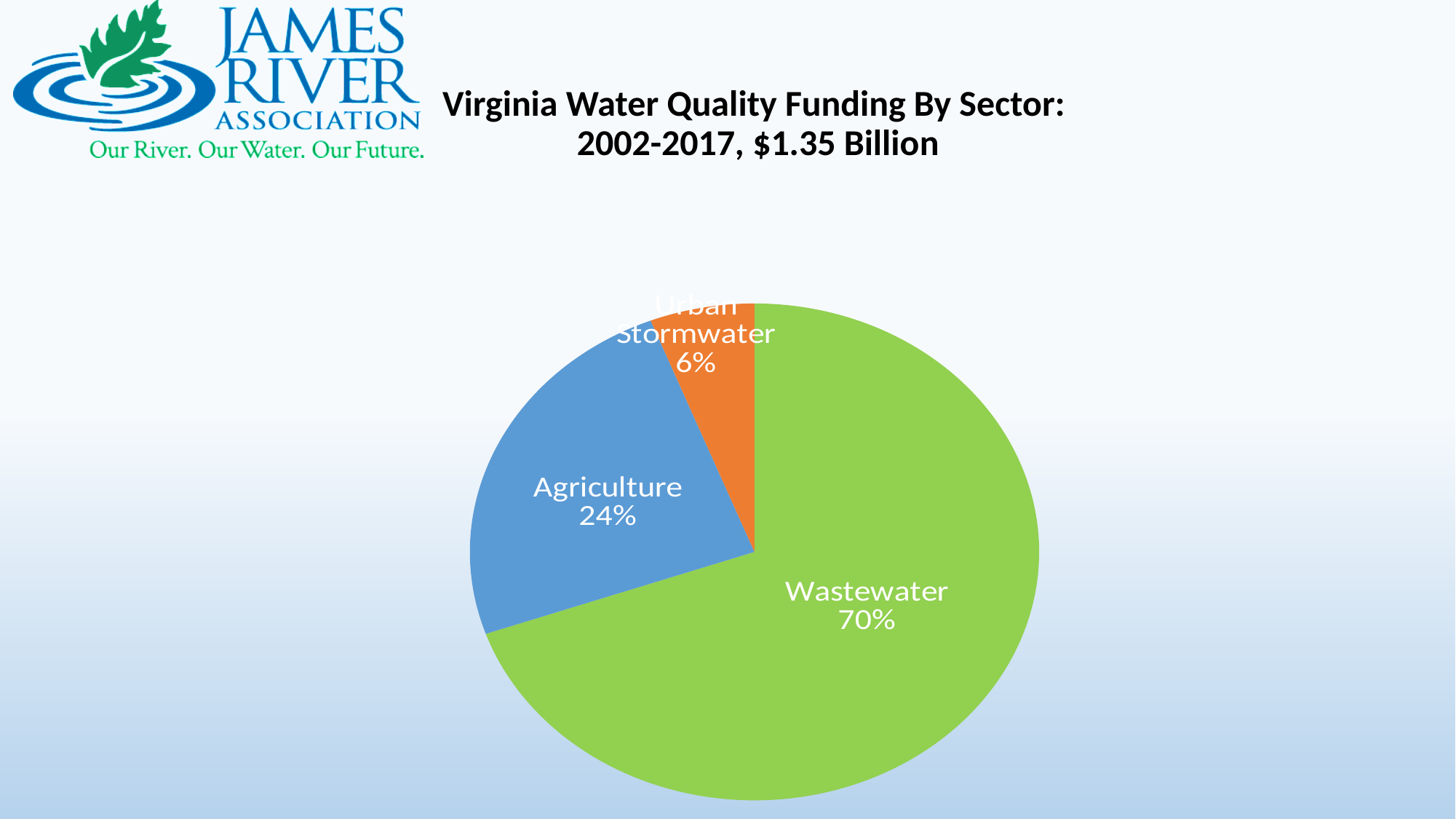
How many sectors are shown in the pie chart? 3 Which sector has the smallest share of funding? Urban Stormwater What is the difference in percentage points between Wastewater and Agriculture? 46 What is the difference in percentage points between Agriculture and Urban Stormwater? 18 What share of funding does Wastewater receive? 70% Which has a larger share, Agriculture or Urban Stormwater? Agriculture What is the title of the chart? Virginia Water Quality Funding By Sector: 2002-2017, $1.35 Billion What share of funding does Urban Stormwater receive? 6% What share of funding does Agriculture receive? 24% What type of chart is shown on the slide? pie chart What colour is the Wastewater slice? green Which sector has the largest share of funding? Wastewater